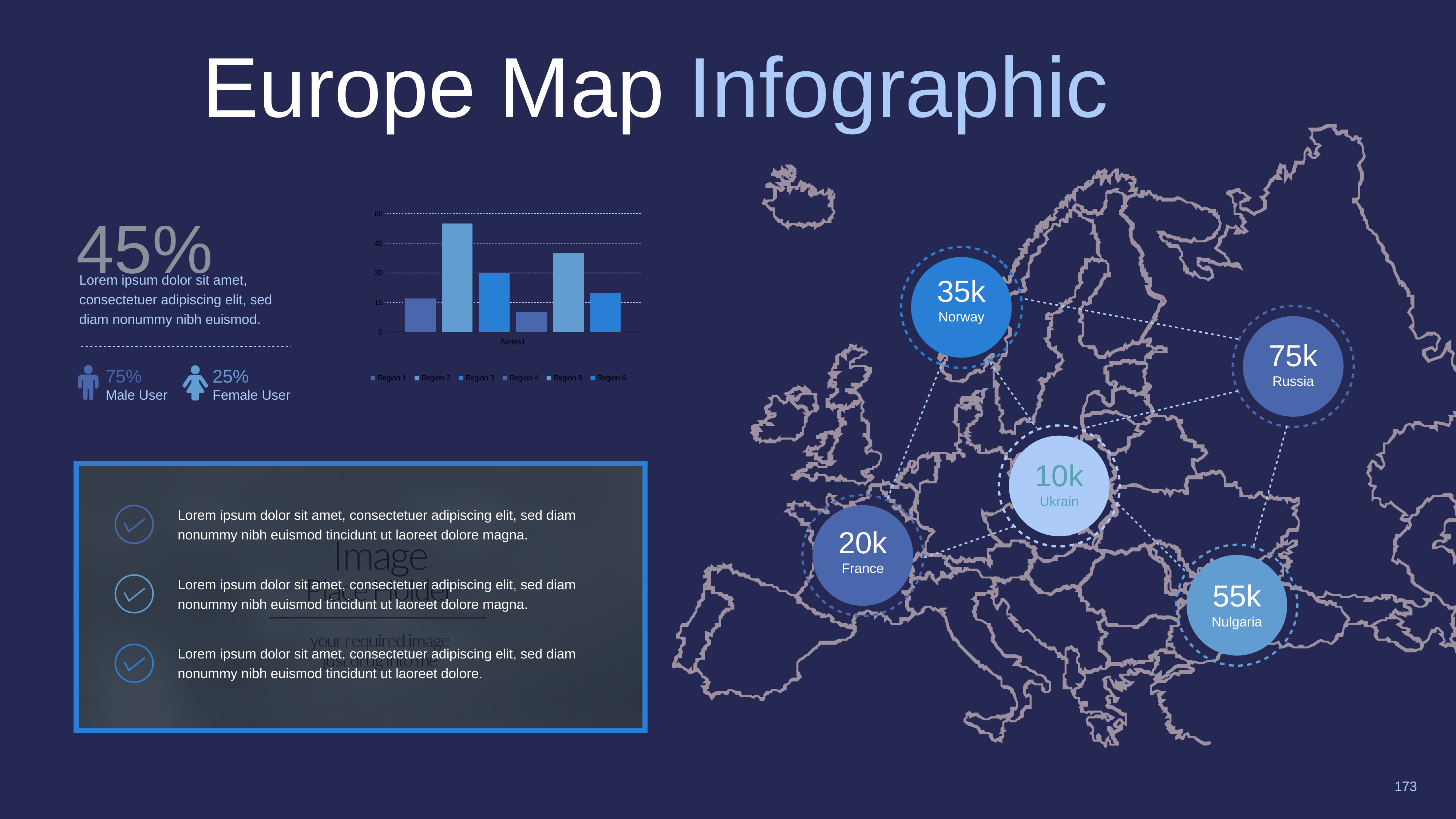
Is the value for Region 6 greater or less than 30? less How many series does the chart legend list? 6 Is the value for Region 5 greater or less than 30? greater What is the category label shown on the x axis of the chart? Series1 Which region has the tallest bar in the chart? Region 2 Which region has the shortest bar in the chart? Region 4 Is the value for Region 2 greater or less than 45? greater What is the value for Region 3 in the chart? 30 Which is larger in the chart, Region 1 or Region 2? Region 2 What kind of chart is shown on the slide? bar chart Which is larger in the chart, Region 5 or Region 3? Region 5